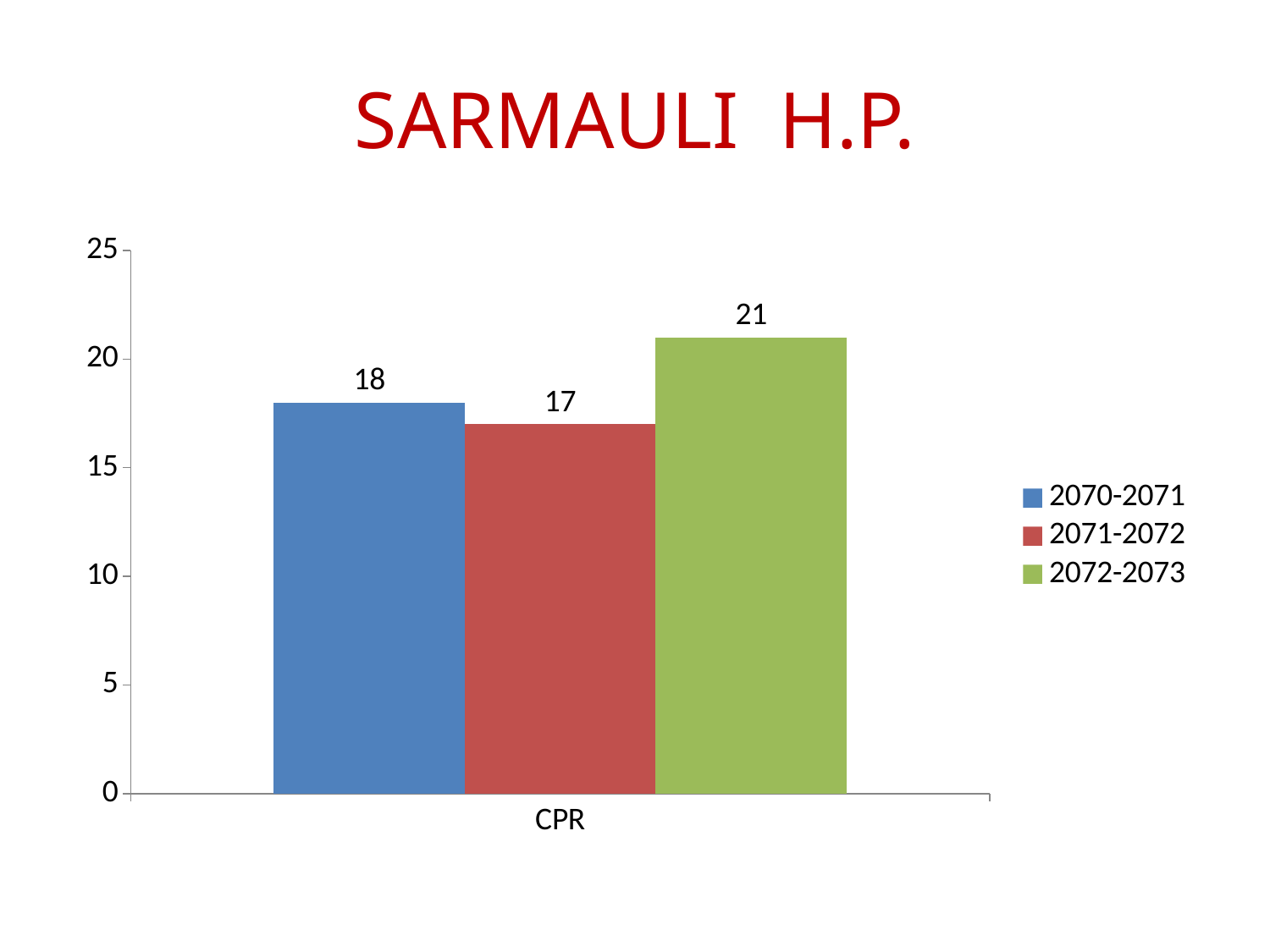
Which is larger, the CPR value for 2070-2071 or for 2072-2073? 2072-2073 What is the CPR value for 2072-2073? 21 What is the difference between the CPR values for 2070-2071 and 2071-2072? 1 What is the difference between the CPR values for 2072-2073 and 2071-2072? 4 How many series does the legend list? 3 What is the title of the slide? SARMAULI H.P. What is the CPR value for 2071-2072? 17 What is the CPR value for 2070-2071? 18 Which series has the lowest CPR value? 2071-2072 Which series has the highest CPR value? 2072-2073 What kind of chart is shown on the slide? bar chart Is the CPR value for 2072-2073 greater or less than 20? greater